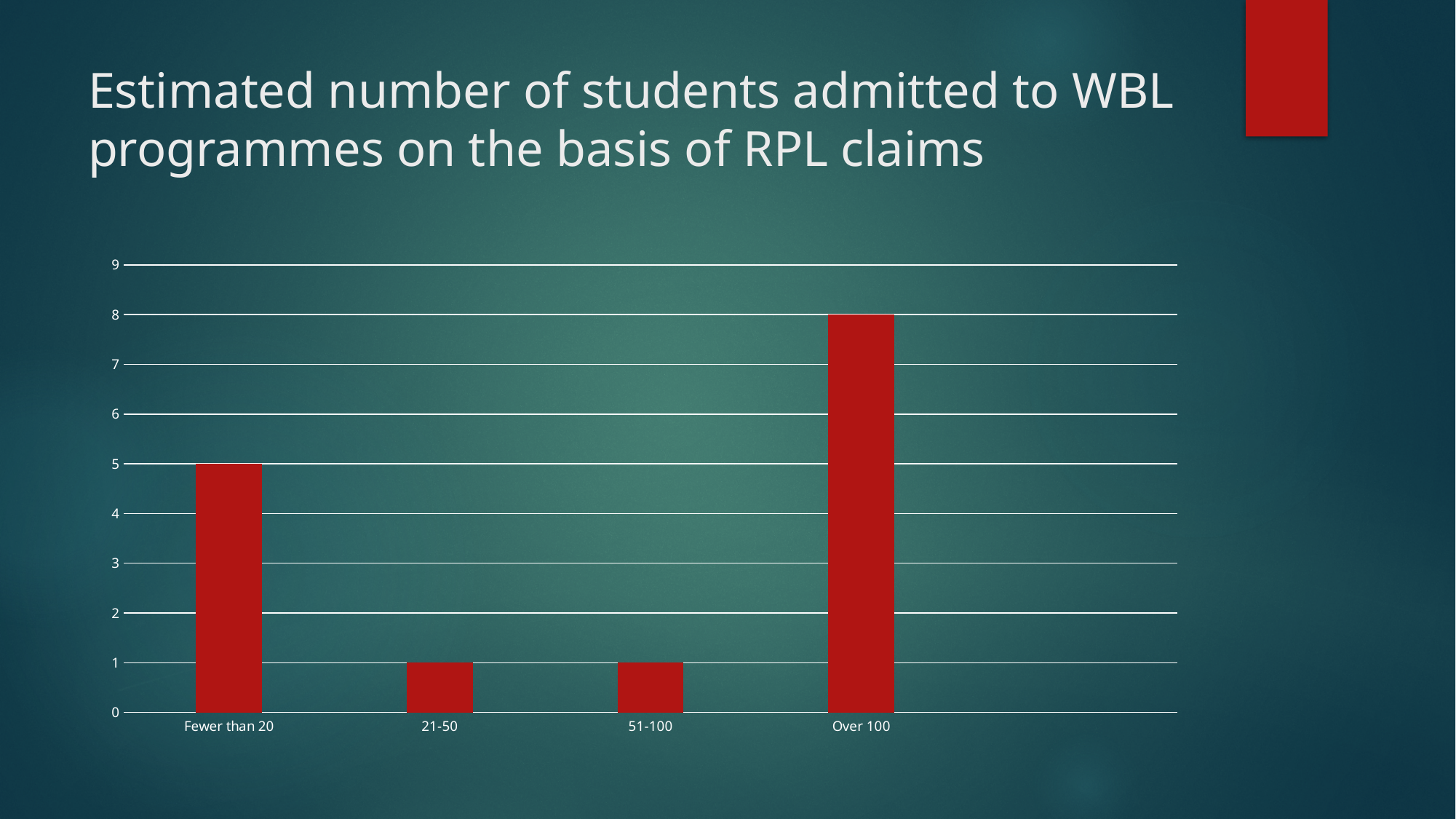
What is the value for the 'Fewer than 20' category? 5 What is the title of the slide containing the chart? Estimated number of students admitted to WBL programmes on the basis of RPL claims What is the value for the '51-100' category? 1 Which is larger, the value for 'Fewer than 20' or the value for '21-50'? Fewer than 20 What kind of chart is shown on the slide? bar chart Is the value for '51-100' greater or less than 3? less Which category has the highest value? Over 100 What is the value for the 'Over 100' category? 8 What is the difference between the values for 'Over 100' and 'Fewer than 20'? 3 How many categories are shown on the x axis? 4 What is the value for the '21-50' category? 1 Is the value for 'Over 100' greater or less than 6? greater